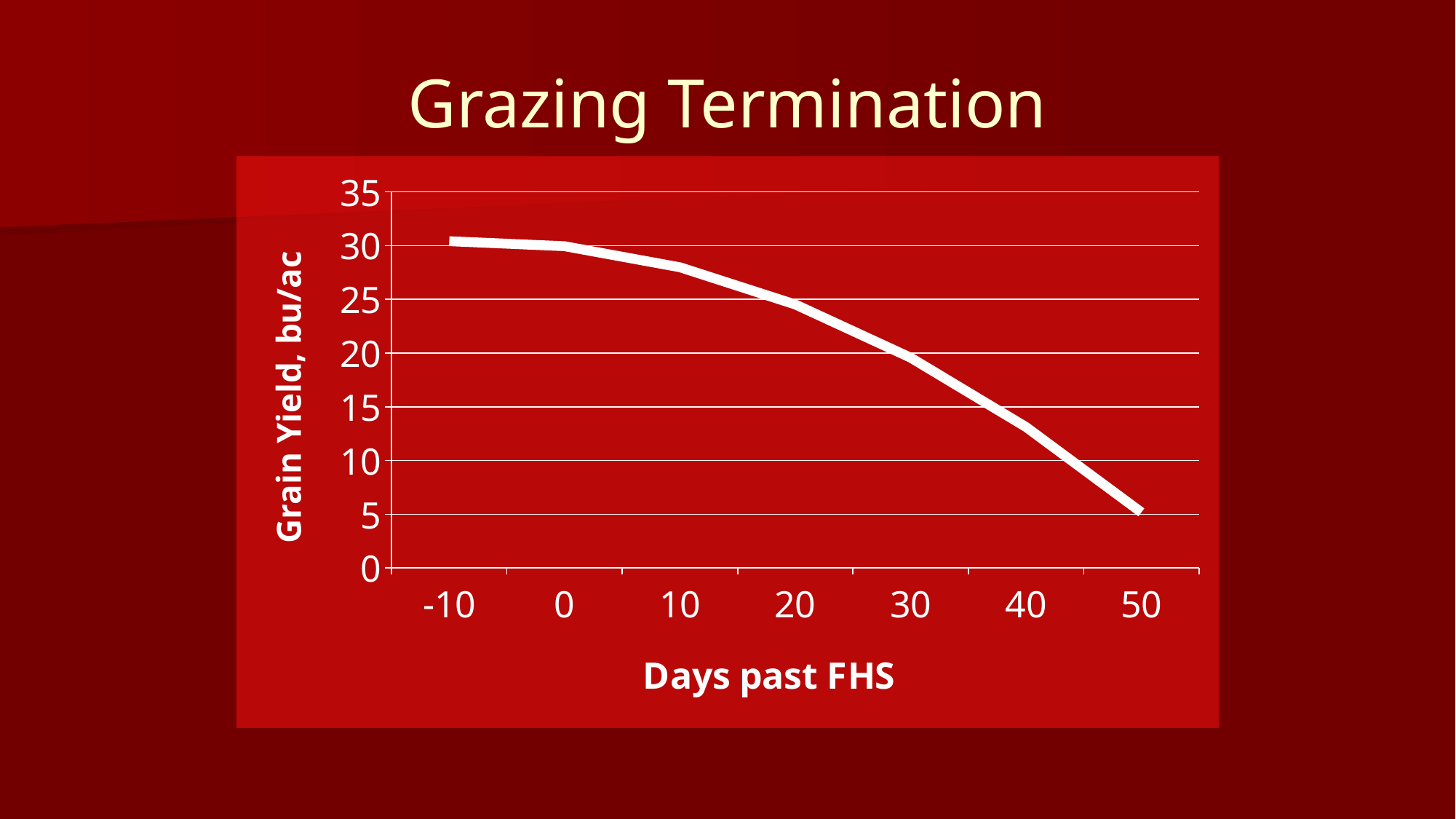
What is the label of the y axis? Grain Yield, bu/ac Which has the higher grain yield: 10 days past FHS or 40 days past FHS? 10 days past FHS What kind of chart is shown on the slide? line chart How many tick labels are shown on the x axis? 7 Is the grain yield at 40 days past FHS greater or less than 10? greater Is the grain yield at 10 days past FHS greater or less than 25? greater At which value of days past FHS is grain yield lowest? 50 Is the grain yield at 50 days past FHS greater or less than 10? less What is the title of the chart? Grazing Termination Does grain yield rise or fall as days past FHS increase? fall